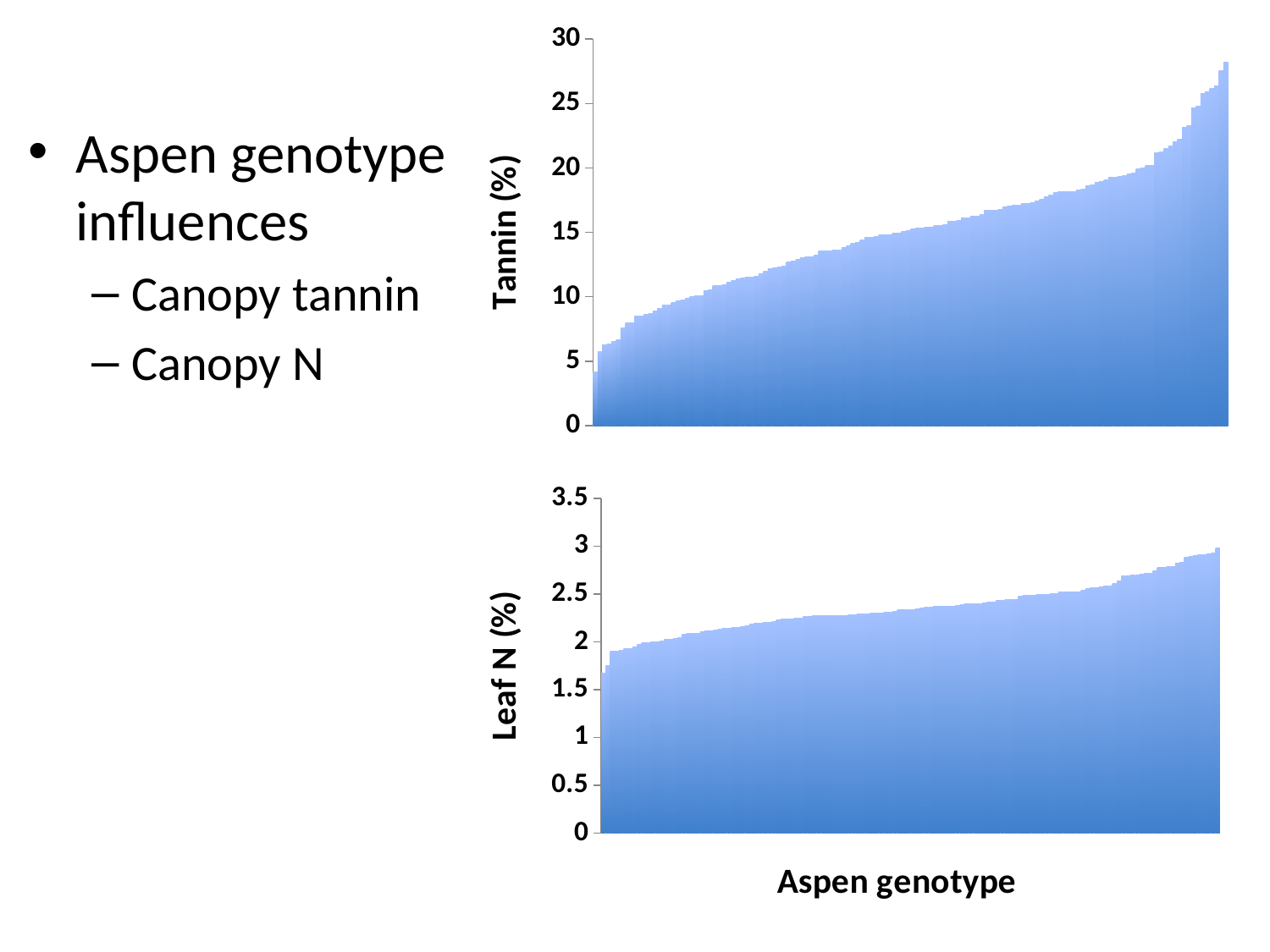
In the top chart (Tannin (%)), is the value of the shortest bar greater or less than 10? less In the bottom chart (Leaf N (%)), is the value of the tallest bar greater or less than 2.5? greater In the bottom chart (Leaf N (%)), do the values rise or fall from left to right along the x axis? rise What kind of chart is the top chart (Tannin (%))? bar chart In the top chart (Tannin (%)), is the value of the tallest bar greater or less than 25? greater What is the x-axis label shown beneath the bottom chart? Aspen genotype What kind of chart is the bottom chart (Leaf N (%))? bar chart In the top chart (Tannin (%)), do the values rise or fall from left to right along the x axis? rise What is the y-axis label of the top chart? Tannin (%)